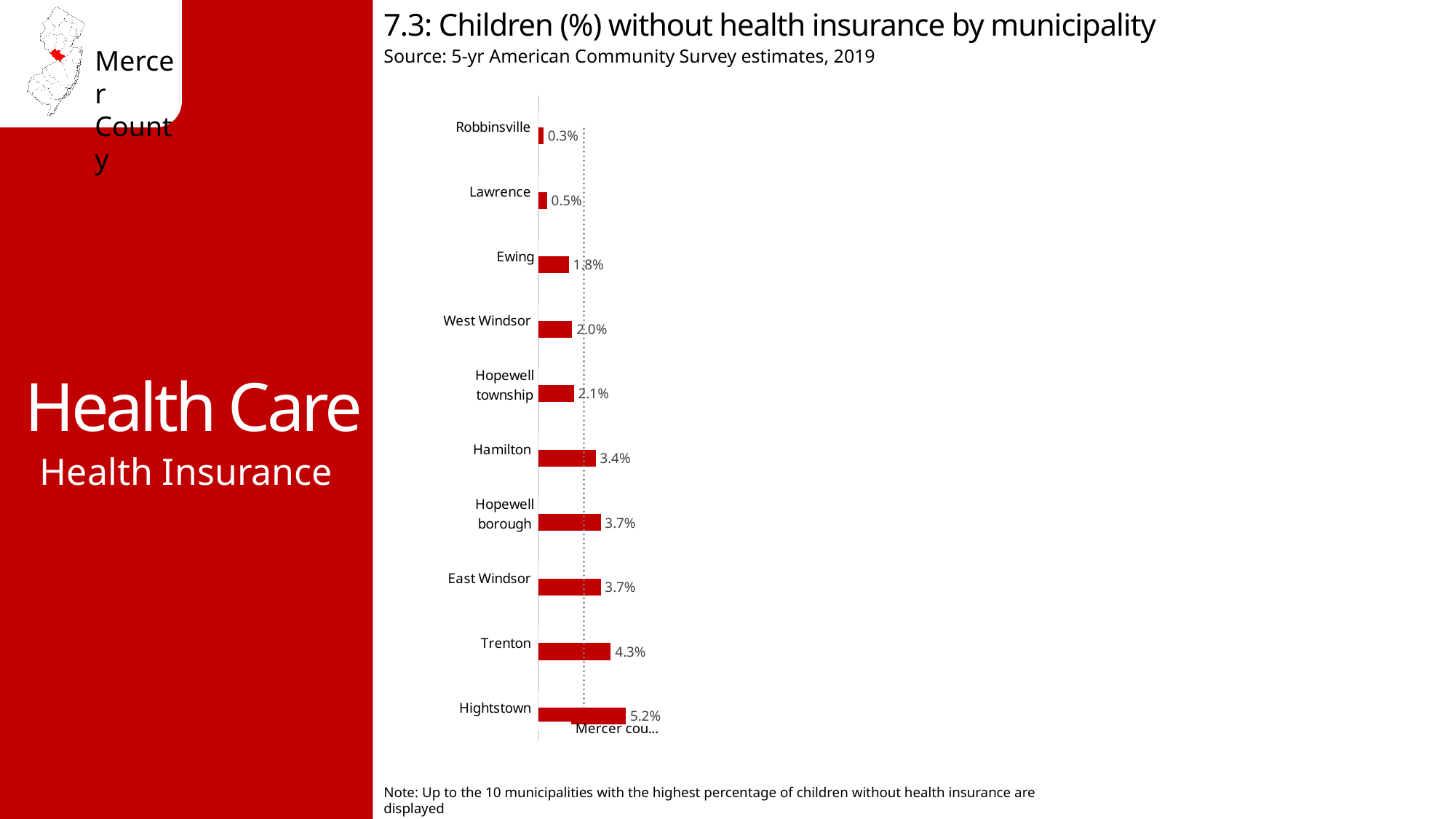
What is the value for Hopewell township? 2.1% What type of chart is shown on the slide? Bar chart What is the source of the data shown in the chart? 5-yr American Community Survey estimates, 2019 What is the difference between the values for Hightstown and Trenton? 0.9% Which has a higher value, Hamilton or West Windsor? Hamilton Which municipality has the lowest percentage of children without health insurance? Robbinsville What percentage is shown for Robbinsville? 0.3% How many municipalities are shown in the chart? 10 What percentage of children in Hightstown are without health insurance? 5.2% What is the difference between the values for Hamilton and Ewing? 1.6% Which municipality has the highest percentage of children without health insurance? Hightstown What is the value shown for Trenton? 4.3%